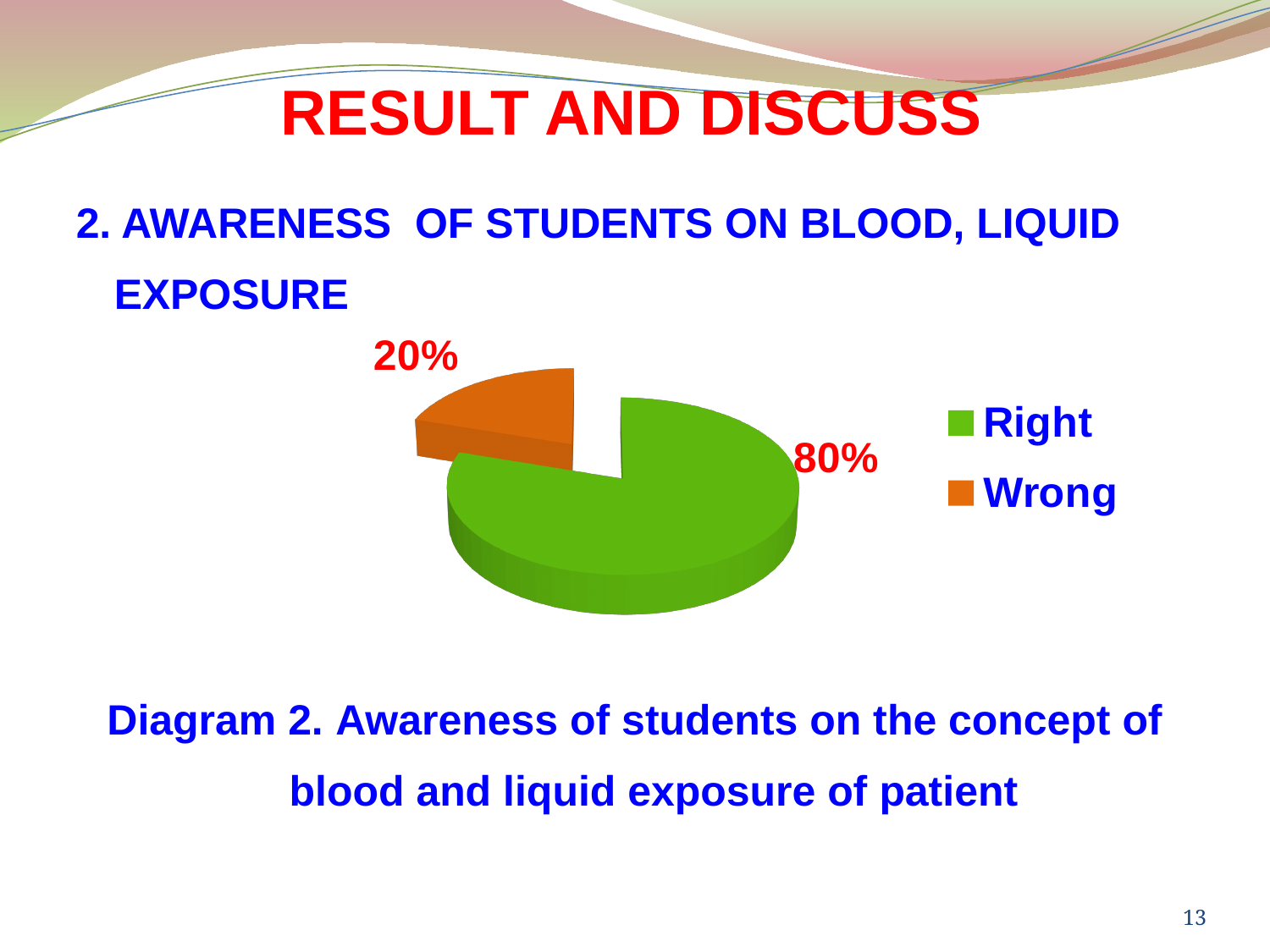
What share of the pie is labelled Wrong? 20% How many entries does the legend list? 2 What is the difference in percentage points between the Right and Wrong slices? 60 What colour is the Wrong slice in the pie chart? orange Which slice of the pie is the smallest? Wrong What kind of chart is shown on the slide? pie chart What is the total of the two slices shown in the pie chart? 100% What colour is the Right slice in the pie chart? green Which is larger, the Right slice or the Wrong slice? Right How many slices does the pie chart have? 2 Which slice of the pie is the largest? Right What share of the pie is labelled Right? 80%